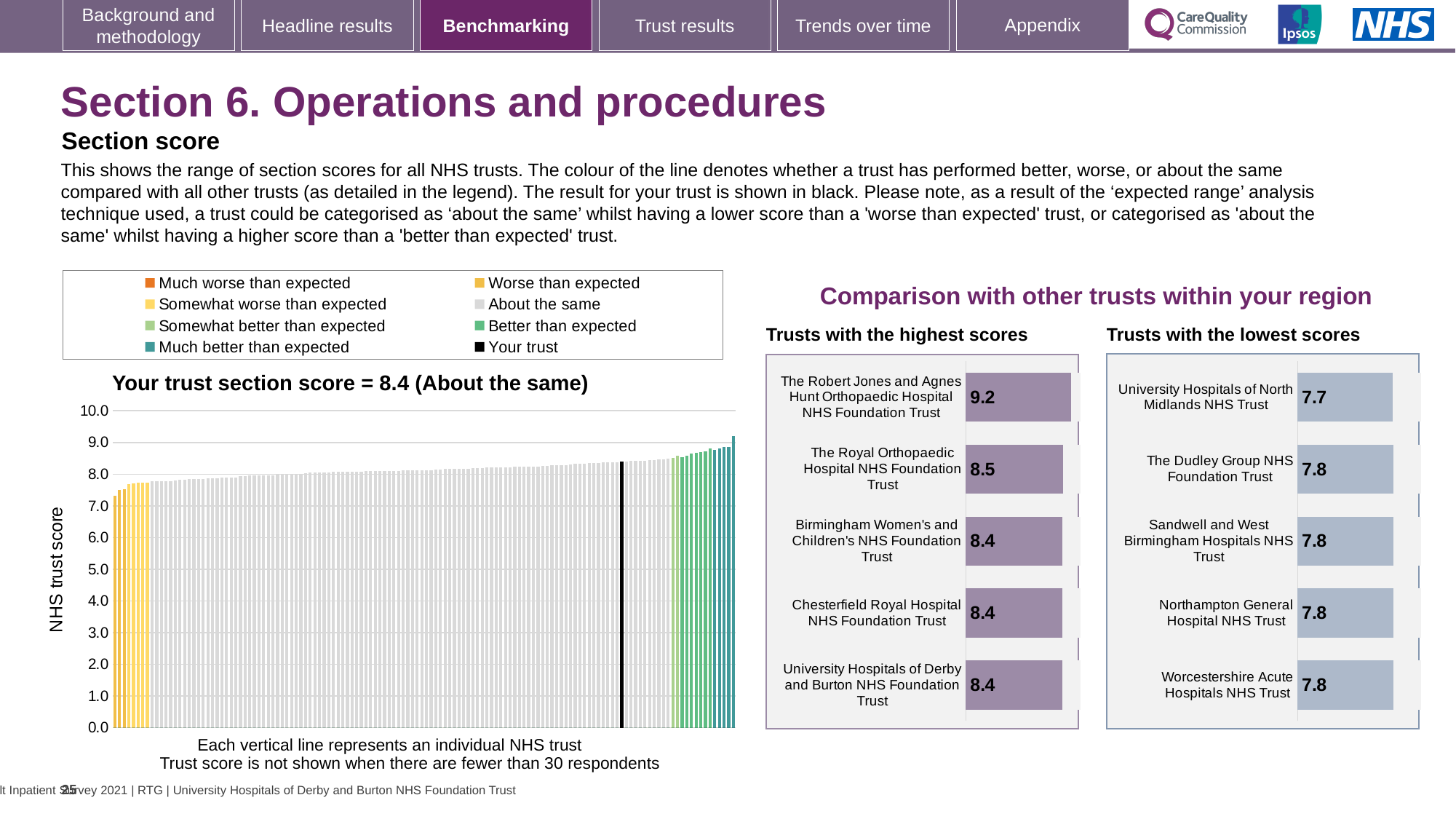
In the 'Your trust section score' chart, what kind of chart is shown? bar chart How many trusts are shown in the 'Trusts with the lowest scores' chart? 5 In the 'Your trust section score' chart, what is the section score for your trust? 8.4 In the 'Trusts with the highest scores' chart, what is the difference between the scores of The Robert Jones and Agnes Hunt Orthopaedic Hospital NHS Foundation Trust and The Royal Orthopaedic Hospital NHS Foundation Trust? 0.7 In the 'Your trust section score' chart, what is the label on the vertical axis? NHS trust score In the 'Trusts with the lowest scores' chart, what is the score for Worcestershire Acute Hospitals NHS Trust? 7.8 In the 'Trusts with the highest scores' chart, which trust has the highest score? The Robert Jones and Agnes Hunt Orthopaedic Hospital NHS Foundation Trust How many entries does the legend above the 'Your trust section score' chart list? 8 In the 'Trusts with the highest scores' chart, what is the score for The Royal Orthopaedic Hospital NHS Foundation Trust? 8.5 In the 'Your trust section score' chart, do the values rise or fall from left to right? rise In the 'Your trust section score' chart, is the value for the lowest-scoring trust greater or less than 7.0? greater In the 'Trusts with the lowest scores' chart, which trust has the lowest score? University Hospitals of North Midlands NHS Trust